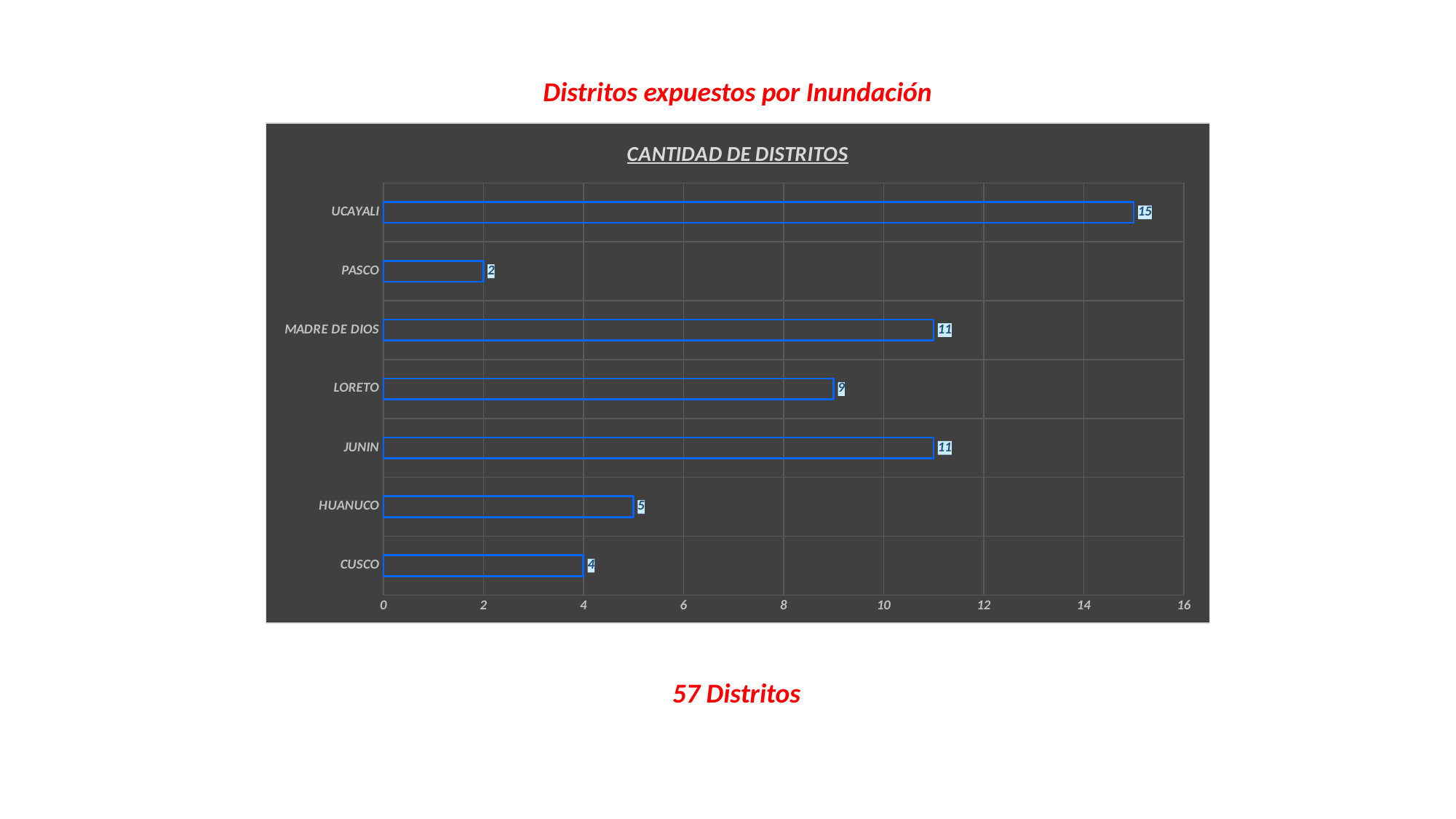
Which is larger, the value for LORETO or the value for HUANUCO? LORETO What is the value for LORETO? 9 What is the value for PASCO? 2 What is the value for UCAYALI? 15 How many categories are shown in the chart? 7 What kind of chart is shown? bar chart Which category has the lowest value? PASCO What is the difference between the values for UCAYALI and MADRE DE DIOS? 4 What is the title of the chart? CANTIDAD DE DISTRITOS Which category has the highest value? UCAYALI What is the value for HUANUCO? 5 Is the value for JUNIN greater or less than 10? greater